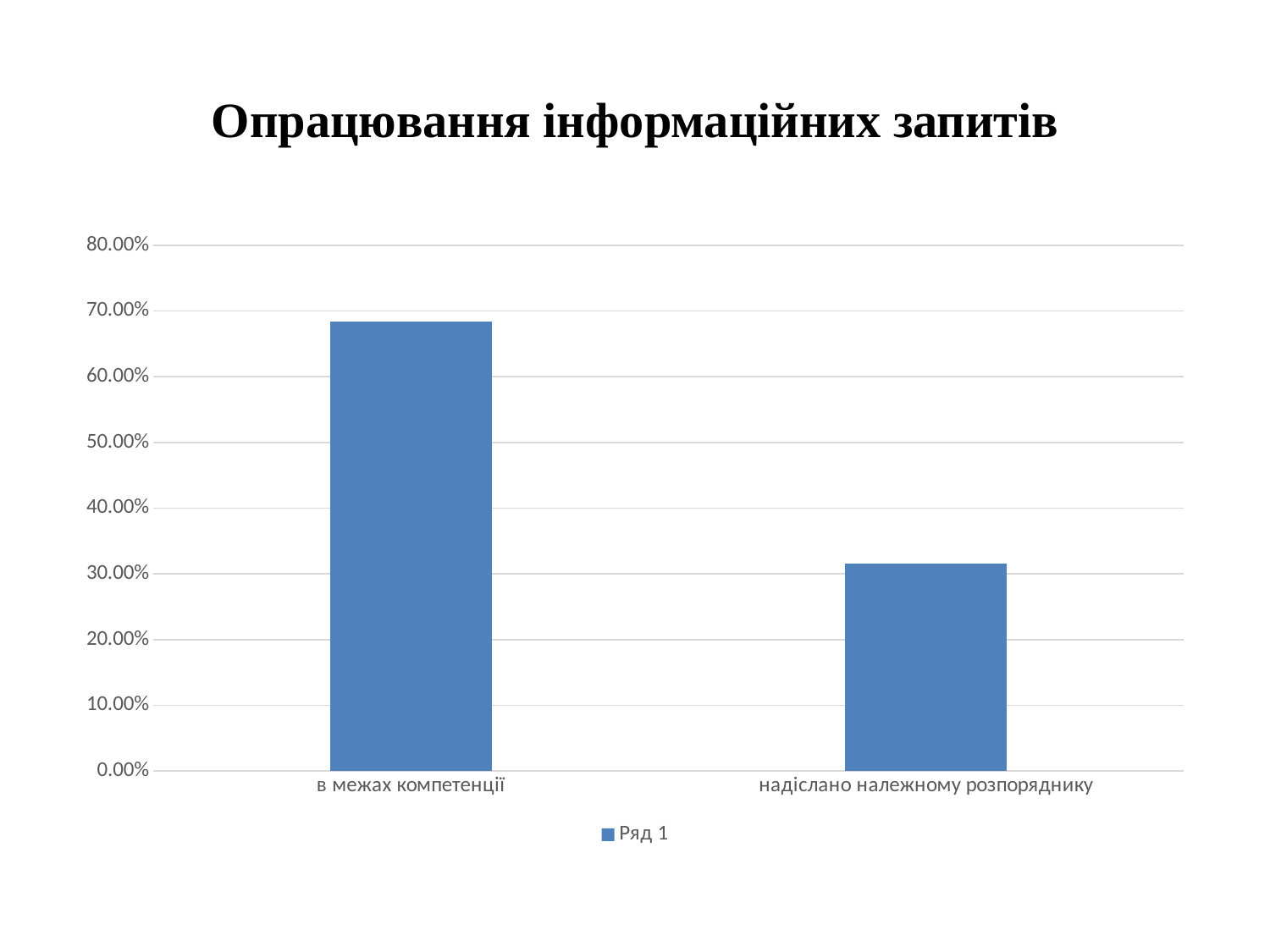
Is the value for 'в межах компетенції' greater or less than 60.00%? greater Which is larger: the value for 'в межах компетенції' or for 'надіслано належному розпоряднику'? в межах компетенції Is the value for 'надіслано належному розпоряднику' greater or less than 30.00%? greater What series name is shown in the legend? Ряд 1 Is the value for 'надіслано належному розпоряднику' greater or less than 40.00%? less Which category has the lowest value? надіслано належному розпоряднику What kind of chart is shown on the slide? bar chart Which category has the highest value? в межах компетенції How many categories are shown on the x axis? 2 How many series does the legend list? 1 What is the title of the chart? Опрацювання інформаційних запитів